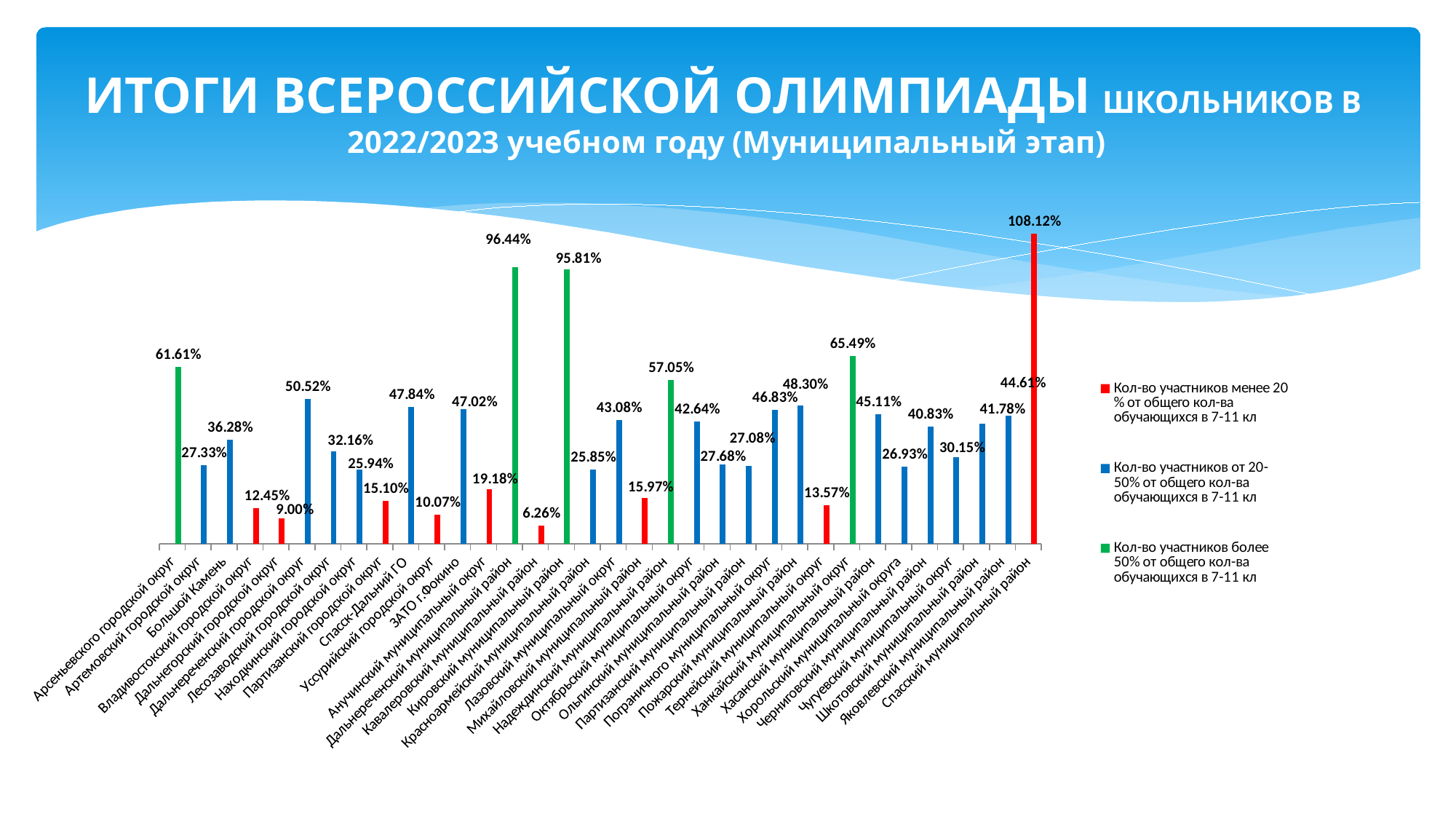
Which category has the highest value? Спасский муниципальный район What is the value for ЗАТО г.Фокино? 47.02% What is the difference between the values for Дальнереченский муниципальный район and Красноармейский муниципальный район? 70.59% What type of chart is shown on the slide? Bar chart What is the value for Ханкайский муниципальный округ? 65.49% What colour are the bars for the legend entry 'Кол-во участников более 50% от общего кол-ва обучающихся в 7-11 кл'? Green What is the value for Арсеньевского городской округ? 61.61% Which is larger: the value for Дальнереченский городской округ or for Спасск-Дальний ГО? Дальнереченский городской округ How many categories are plotted on the chart? 34 What is the value for Кавалеровский муниципальный район? 6.26% Which category has the lowest value? Кавалеровский муниципальный район How many entries does the legend list? 3